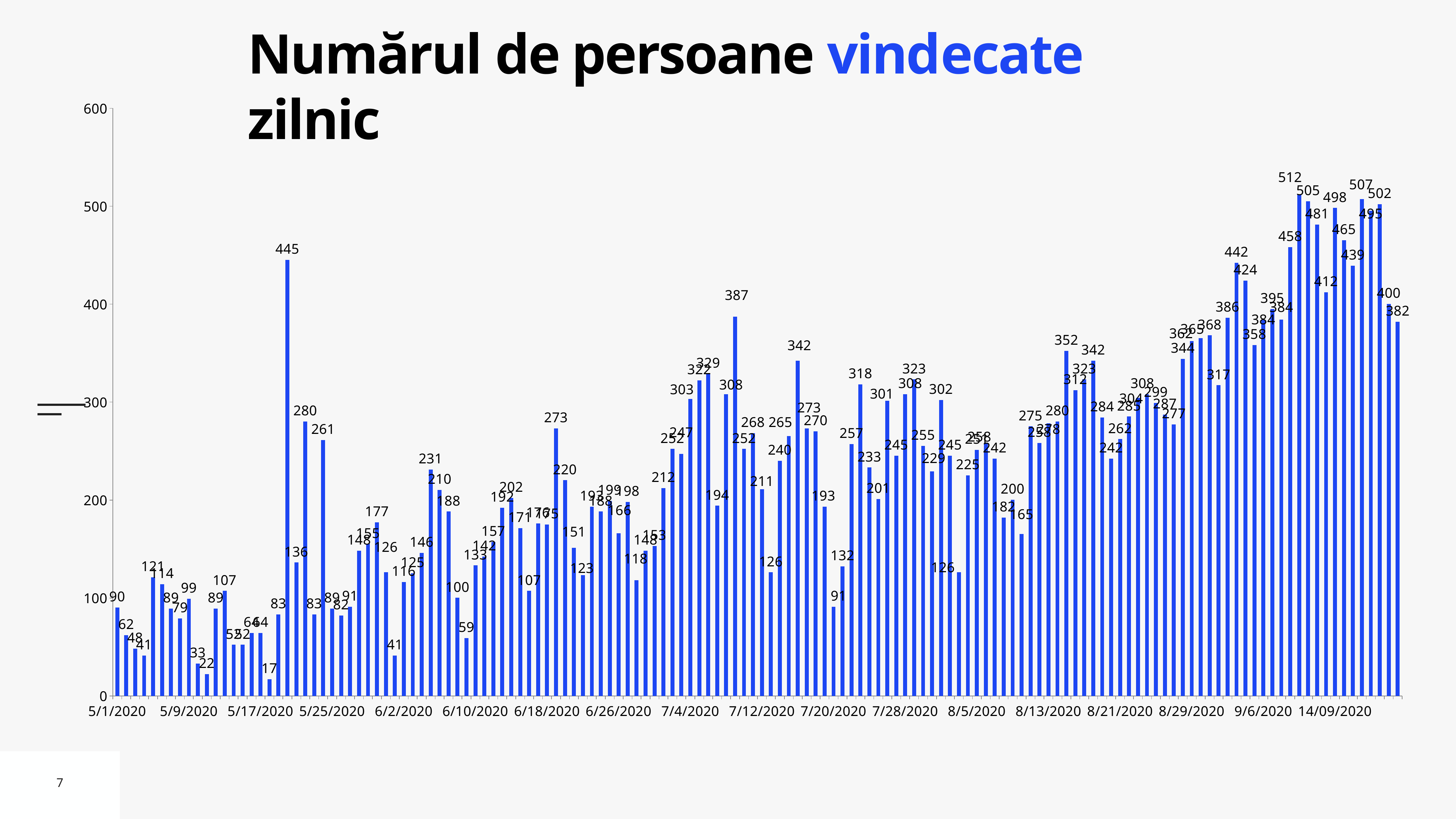
Which is larger, the peak of 445 in May or the peak of 387 in July? 445 Is the value for 5/1/2020 greater or less than 100? less What is the difference between the highest value (512) and the lowest value (17)? 495 What is the value for 5/1/2020? 90 What is the lowest value shown in the chart? 17 What is the title of the chart? Numărul de persoane vindecate zilnic Is the highest bar in the chart greater or less than 500? greater What is the maximum value shown on the vertical axis? 600 What kind of chart is shown on the slide? bar chart Do the values generally rise or fall from May to September along the x axis? rise What is the highest value shown in the chart? 512